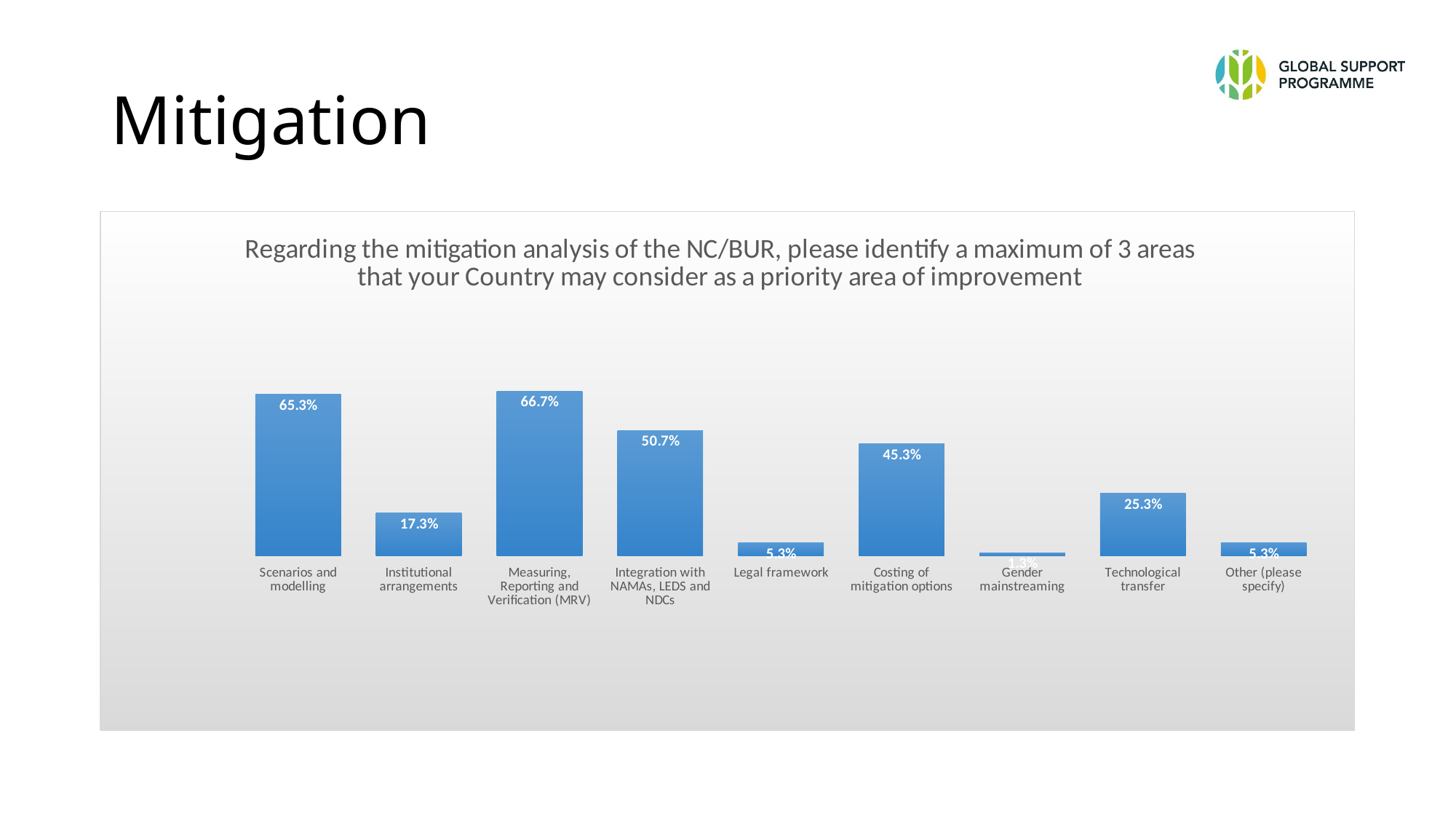
Which is larger, the value for Scenarios and modelling or the value for Costing of mitigation options? Scenarios and modelling What kind of chart is shown on the slide? Bar chart What percentage is shown for Costing of mitigation options? 45.3% What percentage is shown for Scenarios and modelling? 65.3% What percentage is shown for Gender mainstreaming? 1.3% What is the value for Measuring, Reporting and Verification (MRV)? 66.7% Which category has the highest value? Measuring, Reporting and Verification (MRV) What is the value for Technological transfer? 25.3% What is the difference between the values for Measuring, Reporting and Verification (MRV) and Scenarios and modelling? 1.4% How many categories are shown in the chart? 9 What is the difference between the values for Integration with NAMAs, LEDS and NDCs and Institutional arrangements? 33.4% Which category has the lowest value? Gender mainstreaming